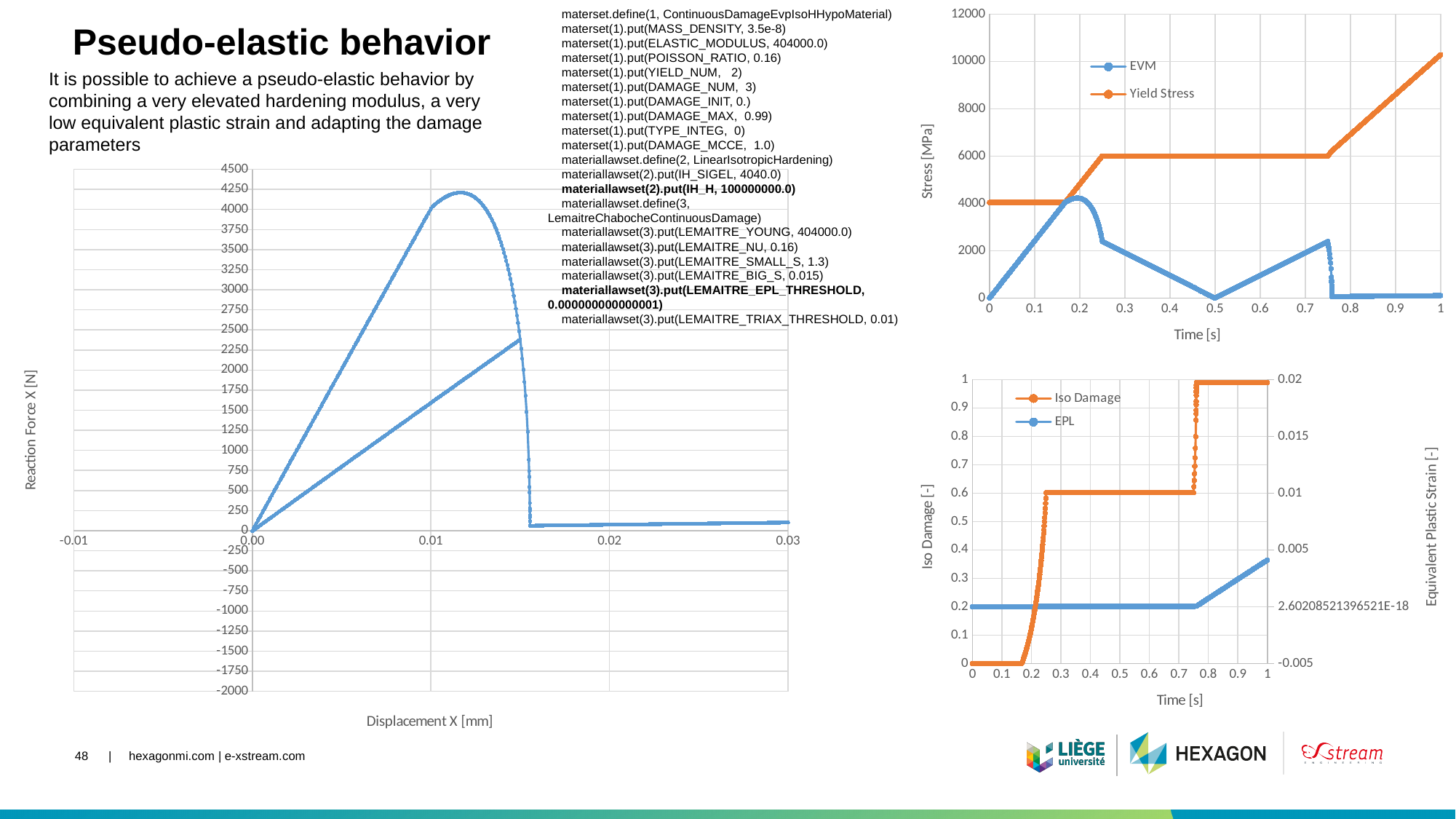
In the top-right chart (Stress vs Time), which series has the larger value at time 0.9, EVM or Yield Stress? Yield Stress What is the y-axis title of the large chart on the left? Reaction Force X [N] In the bottom-right chart (Iso Damage vs Time), is the Iso Damage value at time 0.5 greater or less than 0.4? greater In the bottom-right chart (Iso Damage vs Time), is the Iso Damage value at time 0.1 greater or less than 0.5? less In the top-right chart (Stress vs Time), is the EVM value at time 0.5 greater or less than 2000? less In the top-right chart (Stress vs Time), does the Yield Stress series rise or fall between time 0.75 and time 1? rise In the top-right chart (Stress vs Time), how many series does the legend list? 2 In the bottom-right chart (Iso Damage vs Time), how many series does the legend list? 2 What kind of chart is the large chart on the left showing Reaction Force X against Displacement X? line chart In the top-right chart (Stress vs Time), what are the two legend entries? EVM and Yield Stress